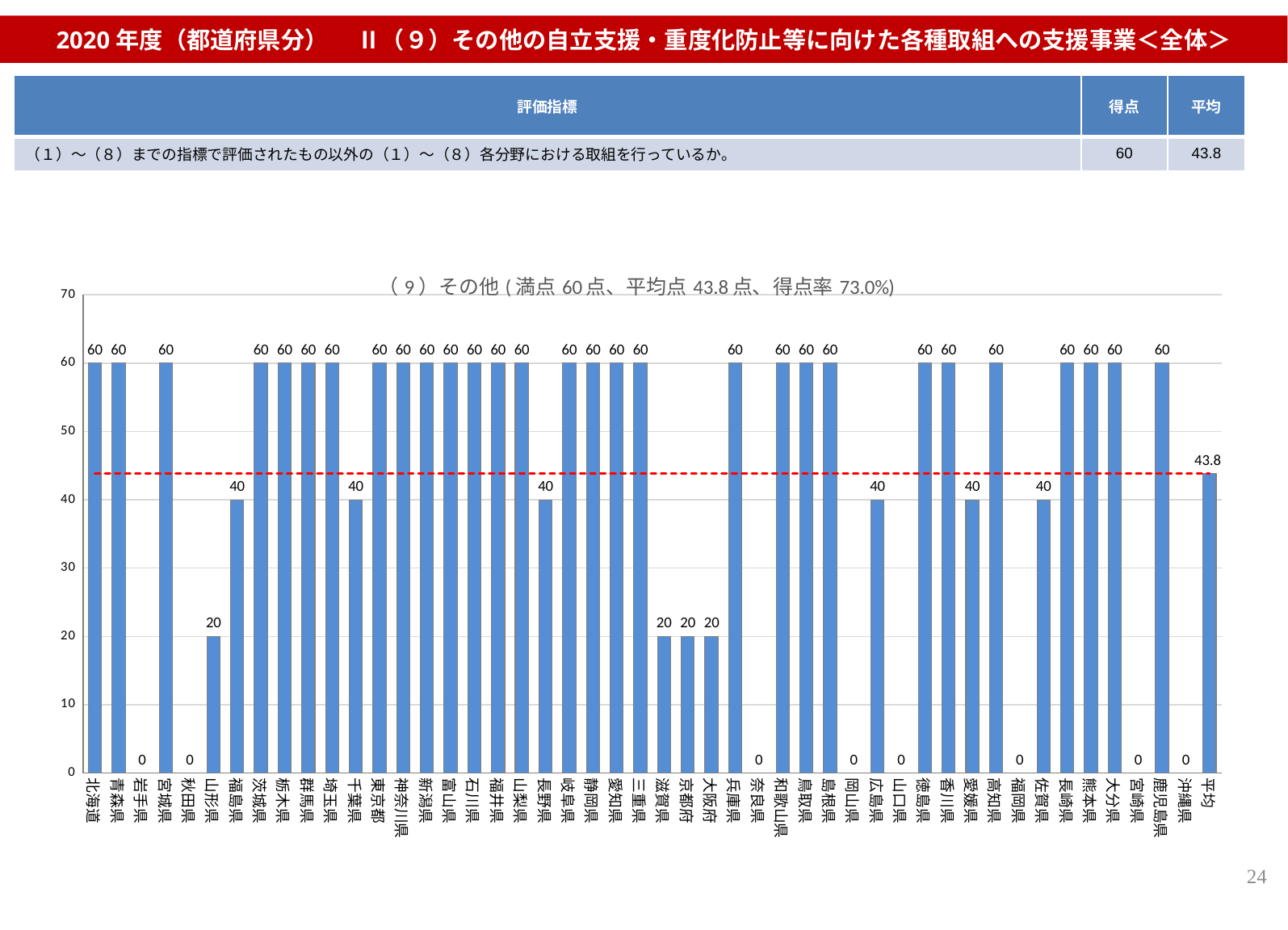
What is the value for 山形県? 20 What is the value for 岩手県? 0 What is the difference between the values for 広島県 and 大阪府? 20 What is the value for 福島県? 40 What is the difference between the values for 北海道 and 千葉県? 20 What kind of chart is shown on the slide? bar chart What is the value for 京都府? 20 Which is larger, the value for 滋賀県 or the value for 佐賀県? 佐賀県 Which is larger, the value for 長野県 or the value for 岐阜県? 岐阜県 What is the value for 平均? 43.8 What value does the red dashed horizontal line mark? 43.8